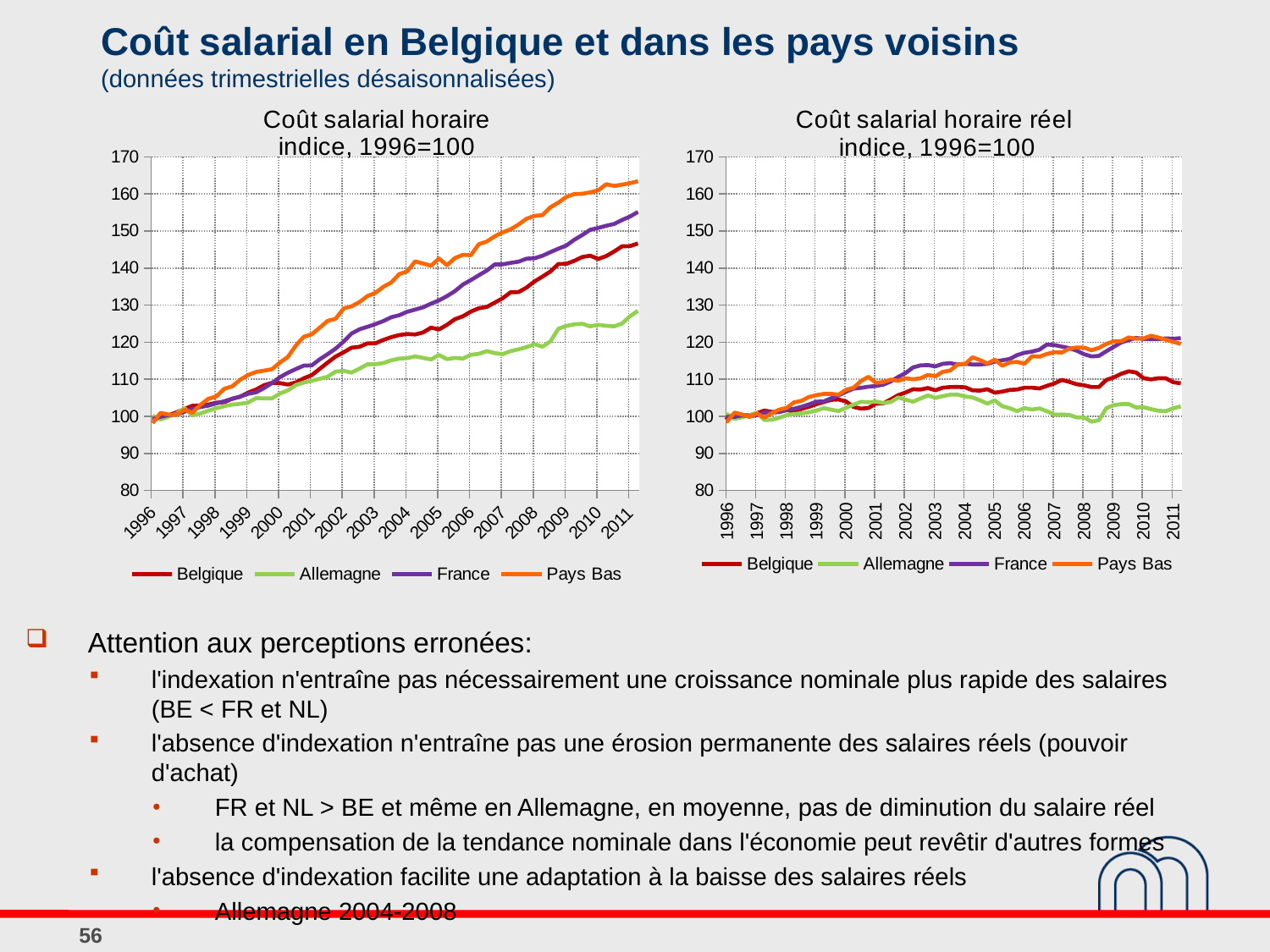
In the left chart, 'Coût salarial horaire indice, 1996=100', which country has the lowest value in 2011? Allemagne In the left chart, 'Coût salarial horaire indice, 1996=100', does the Pays Bas line rise or fall from 1996 to 2011? rise In the right chart, 'Coût salarial horaire réel indice, 1996=100', which country has the lowest value in 2011? Allemagne How many series does the legend of the right chart, 'Coût salarial horaire réel indice, 1996=100', list? 4 In the left chart, 'Coût salarial horaire indice, 1996=100', which is larger in 2011: France or Belgique? France In the left chart, 'Coût salarial horaire indice, 1996=100', is the value for Allemagne in 2011 greater or less than 130? less In the right chart, 'Coût salarial horaire réel indice, 1996=100', which is larger in 2011: Belgique or Allemagne? Belgique In the left chart, 'Coût salarial horaire indice, 1996=100', which country has the highest value in 2011? Pays Bas Which countries are listed in the legend of the left chart, 'Coût salarial horaire indice, 1996=100'? Belgique, Allemagne, France, Pays Bas What kind of chart is the left chart, 'Coût salarial horaire indice, 1996=100'? line chart In the left chart, 'Coût salarial horaire indice, 1996=100', is the value for Pays Bas in 2011 greater or less than 160? greater In the right chart, 'Coût salarial horaire réel indice, 1996=100', is the value for Allemagne in 2011 greater or less than 110? less